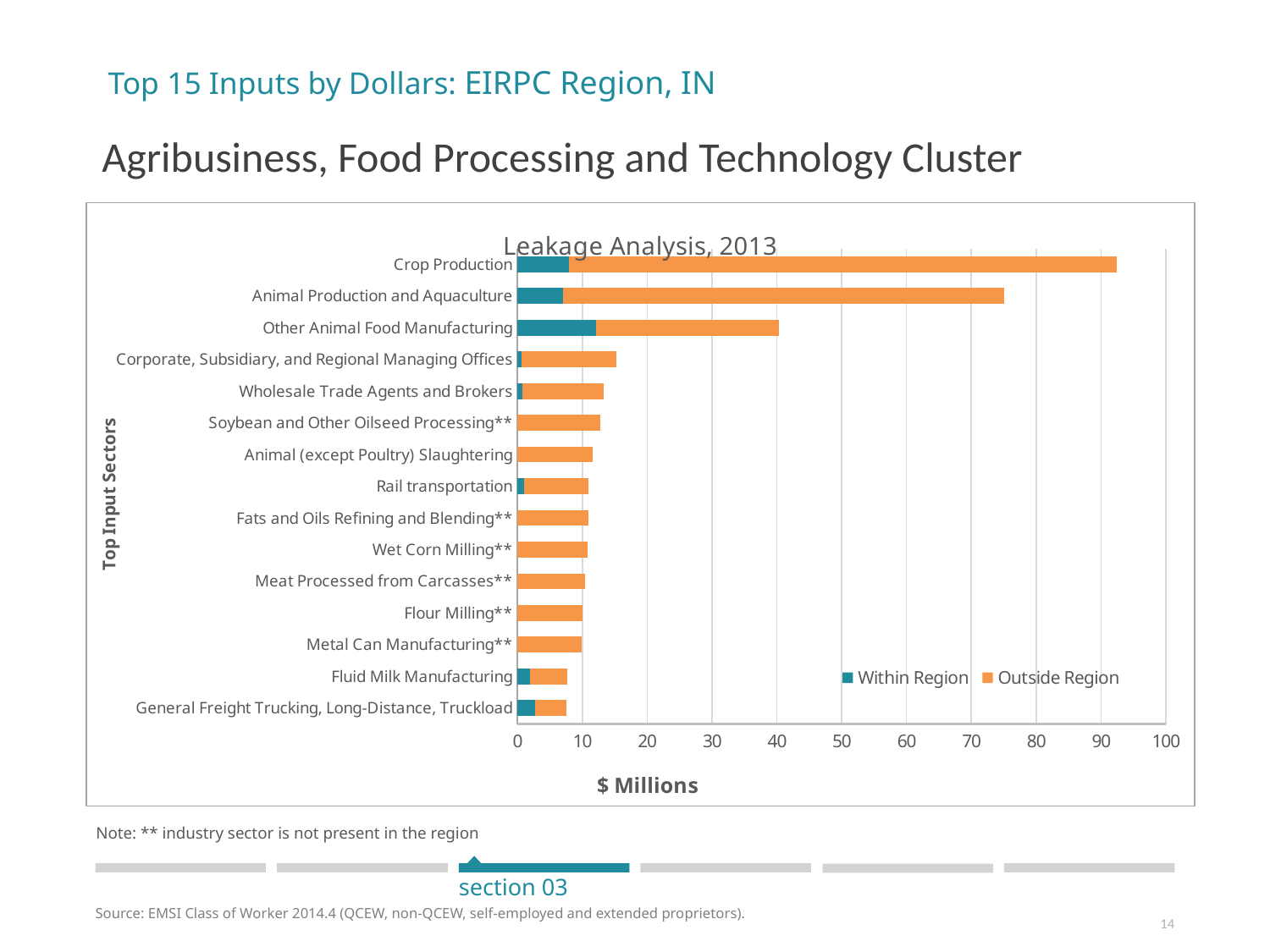
Which has the larger Within Region value: Other Animal Food Manufacturing or Crop Production? Other Animal Food Manufacturing How many series does the chart's legend list? 2 Is the total value for Animal Production and Aquaculture greater or less than 70 $ Millions? greater What is the title of the chart? Leakage Analysis, 2013 What is the label on the horizontal axis of the chart? $ Millions Is the total value for Fluid Milk Manufacturing greater or less than 10 $ Millions? less How many input sectors are plotted on the chart? 15 Which has the larger total bar: Crop Production or Animal Production and Aquaculture? Crop Production Is the total value for Crop Production greater or less than 80 $ Millions? greater What kind of chart is shown on the slide? Stacked bar chart Which input sector has the longest total bar? Crop Production